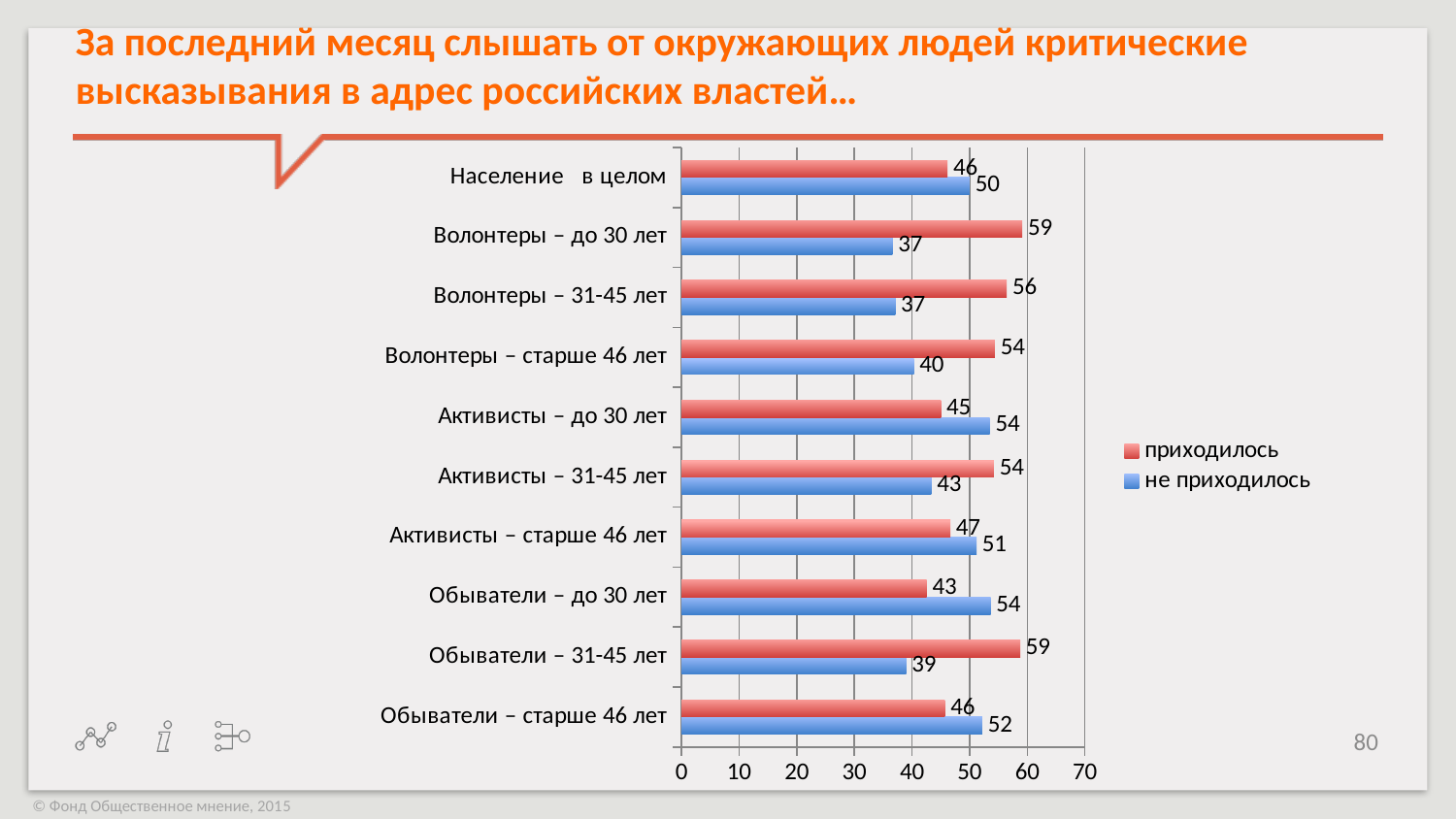
What is the value of "не приходилось" for "Волонтеры – до 30 лет"? 37 For "Активисты – до 30 лет", which is larger: "приходилось" or "не приходилось"? не приходилось Which series is shown in red? приходилось How many categories are shown on the chart? 10 How many series does the legend list? 2 What is the value of "приходилось" for "Население в целом"? 46 What is the value of "приходилось" for "Обыватели – 31-45 лет"? 59 Is the value of "приходилось" for "Волонтеры – 31-45 лет" greater or less than 50? greater What type of chart is shown on the slide? bar chart What is the value of "не приходилось" for "Активисты – старше 46 лет"? 51 What is the difference between "приходилось" and "не приходилось" for "Волонтеры – до 30 лет"? 22 Which category has the lowest value for "приходилось"? Обыватели – до 30 лет